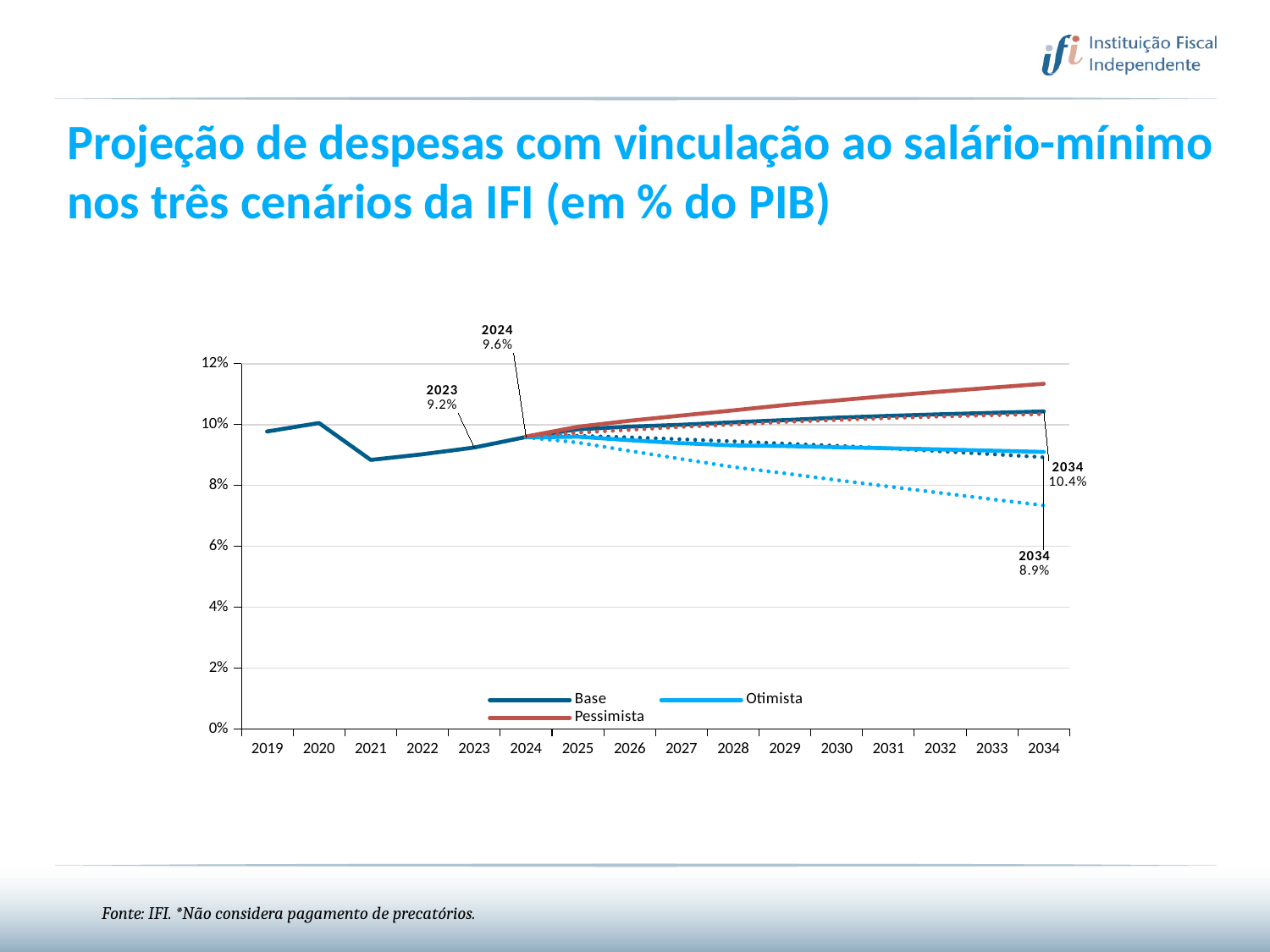
What kind of chart is shown on the slide? Line chart What is the higher of the two values labeled for 2034? 10.4% What value is labeled for 2023? 9.2% Is the value of the Pessimista series in 2034 greater or less than 10%? greater Does the Pessimista line rise or fall between 2024 and 2034? Rises How many series does the legend list? 3 What is the lower of the two values labeled for 2034? 8.9% By how much does the labeled value for 2024 exceed the labeled value for 2023? 0.4 percentage points What are the three series named in the legend? Base, Otimista, Pessimista Which series has the highest value in 2034? Pessimista What value is labeled for 2024? 9.6% Is the value for 2021 greater or less than 10%? less